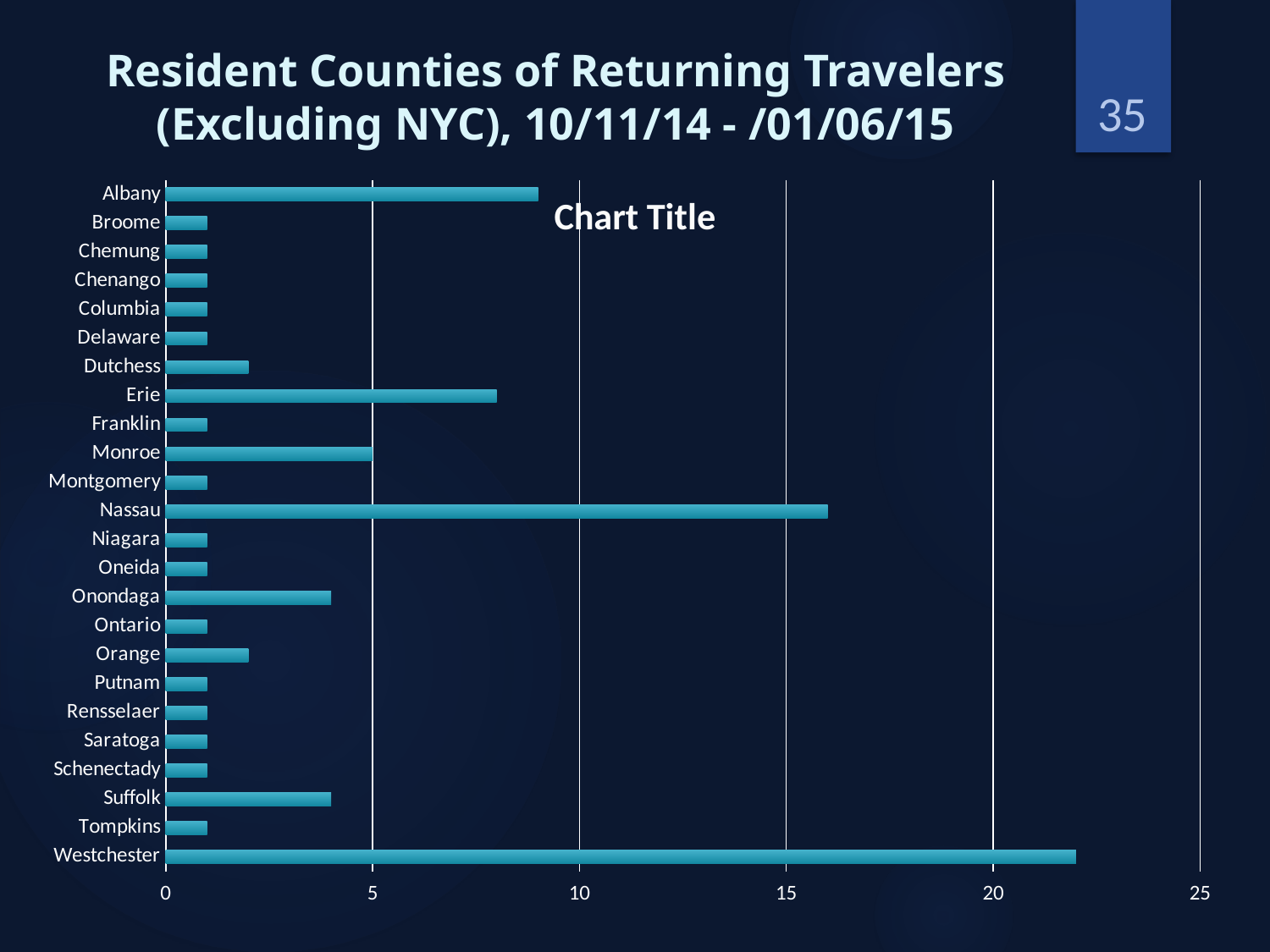
Which has the larger value, Westchester or Nassau? Westchester What kind of chart is shown on the slide? bar chart Is the value for Westchester greater or less than 20? greater Is the value for Erie greater or less than 5? greater Is the value for Nassau greater or less than 15? greater How many counties are listed on the chart's vertical axis? 24 Which has the larger value, Nassau or Albany? Nassau What placeholder title is printed inside the plot area of the chart? Chart Title Which county has the highest value in the chart? Westchester What is the value for Monroe? 5